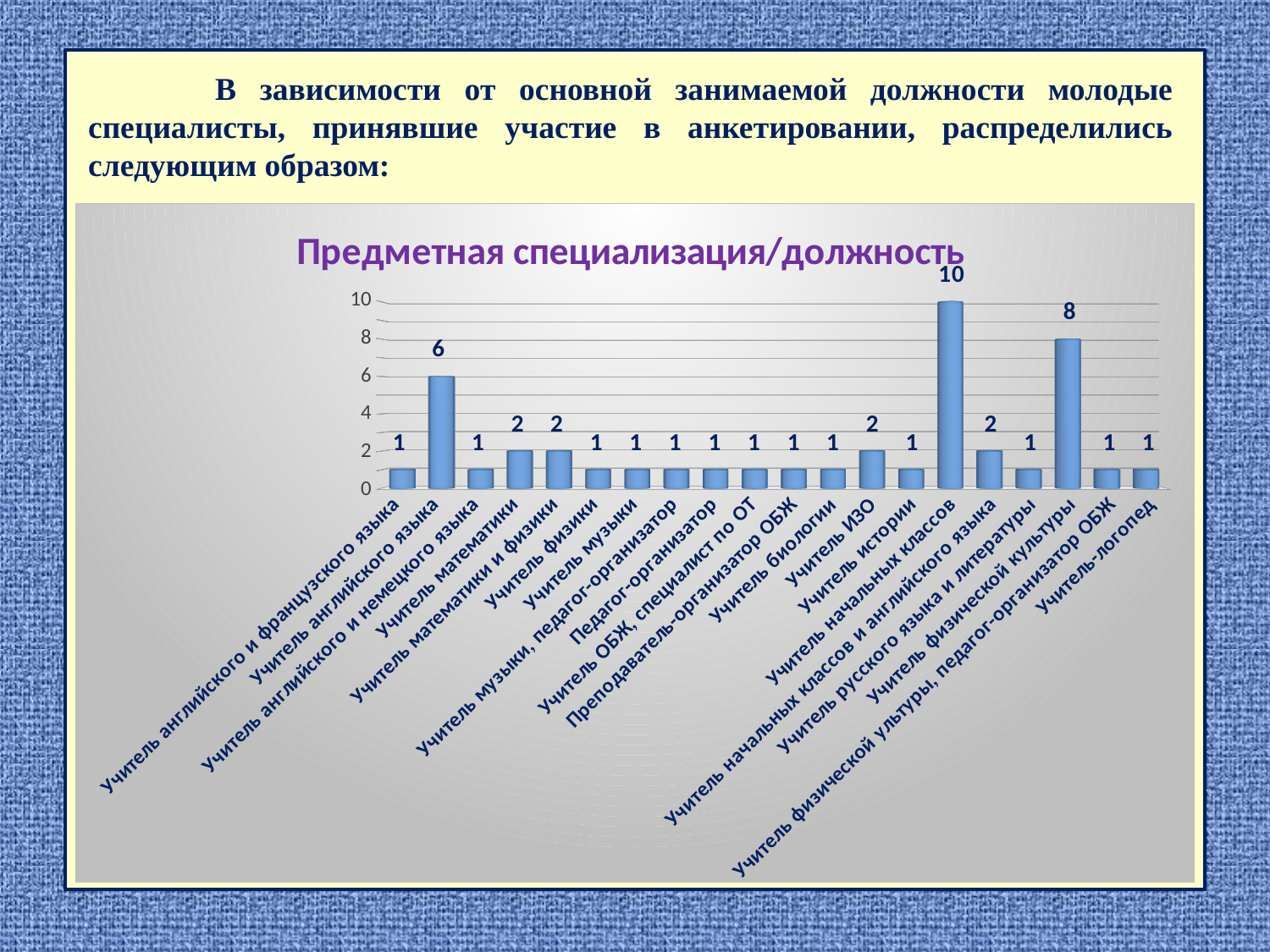
What is the difference between the values for Учитель английского языка and Учитель математики? 4 What is the difference between the values for Учитель начальных классов and Учитель физической культуры? 2 What is the value for Учитель физической культуры? 8 What is the title of the chart? Предметная специализация/должность Which category has the highest value? Учитель начальных классов Which is larger, the value for Учитель физической культуры or the value for Учитель английского языка? Учитель физической культуры What is the value for Учитель ИЗО? 2 What is the value for Учитель английского языка? 6 How many categories are shown on the x axis? 20 What is the value for Учитель начальных классов? 10 What is the value for Учитель-логопед? 1 What type of chart is shown on the slide? bar chart